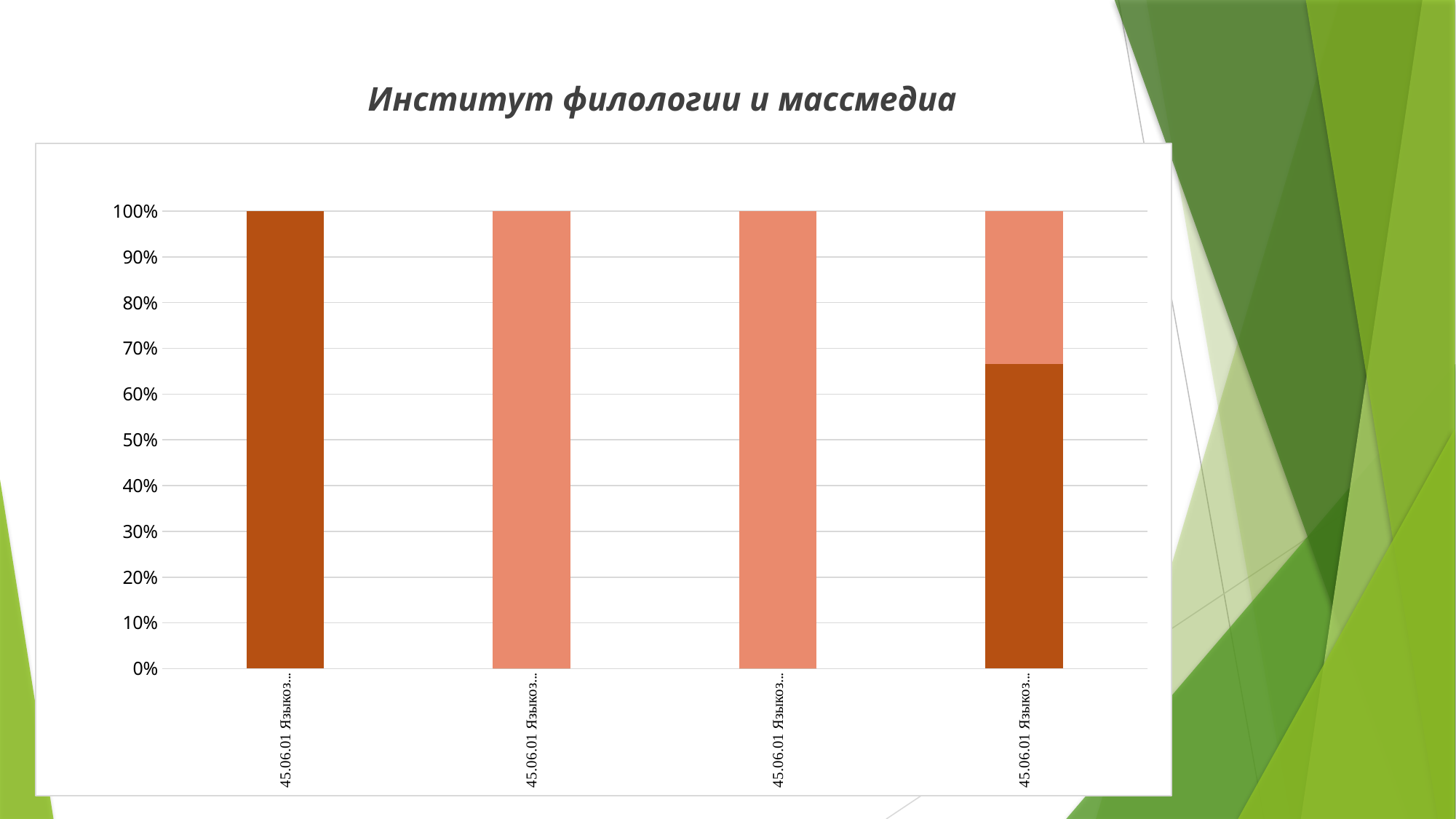
How many bars consist entirely of the light orange colour? 2 How many bars are plotted in the chart? 4 Is the light orange segment of the fourth (rightmost) bar greater or less than 40%? less What is the highest value shown on the vertical axis? 100% Which bar has the larger dark brown segment, the first (leftmost) bar or the fourth (rightmost) bar? the first (leftmost) bar How many bars contain both the dark brown and the light orange colour? 1 What is the total height of the first (leftmost) bar? 100% What kind of chart is shown on the slide? bar chart What is the total height of the fourth (rightmost) bar? 100% Is the dark brown segment of the fourth (rightmost) bar greater or less than 70%? less What is the title of the slide above the chart? Институт филологии и массмедиа Is the dark brown segment of the fourth (rightmost) bar greater or less than 60%? greater